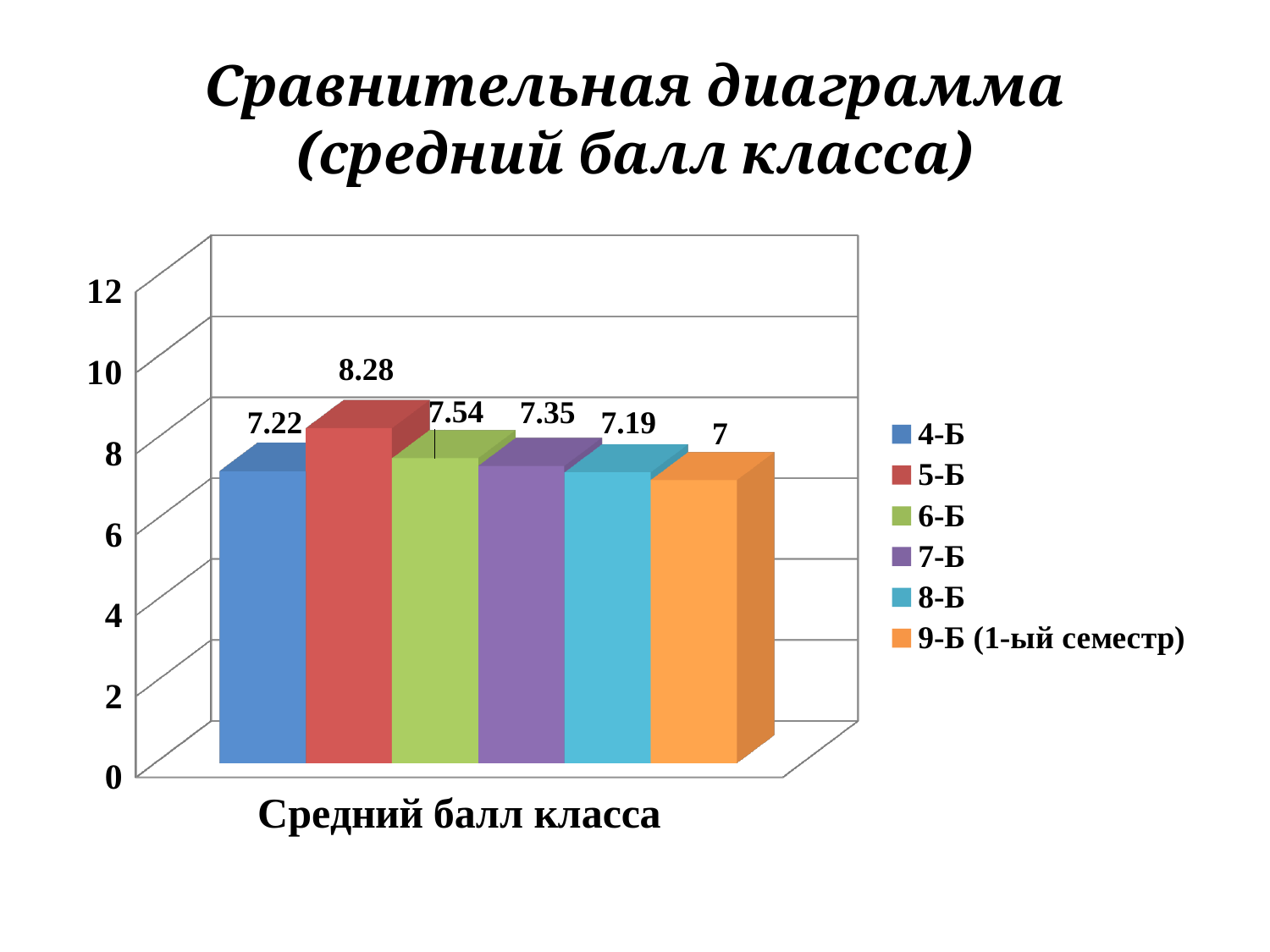
Which class has a higher average score, 6-Б or 7-Б? 6-Б What is the average score for class 4-Б? 7.22 What is the label on the horizontal axis of the chart? Средний балл класса Which class has the highest average score? 5-Б Which class has the lowest average score? 9-Б (1-ый семестр) What is the average score for class 5-Б? 8.28 How many series does the legend list? 6 Is the value for 8-Б greater or less than 8? less What is the difference between the average scores of 5-Б and 4-Б? 1.06 What is the average score for class 9-Б (1-ый семестр)? 7 What colour is the bar for class 6-Б? green What kind of chart is shown on the slide? bar chart